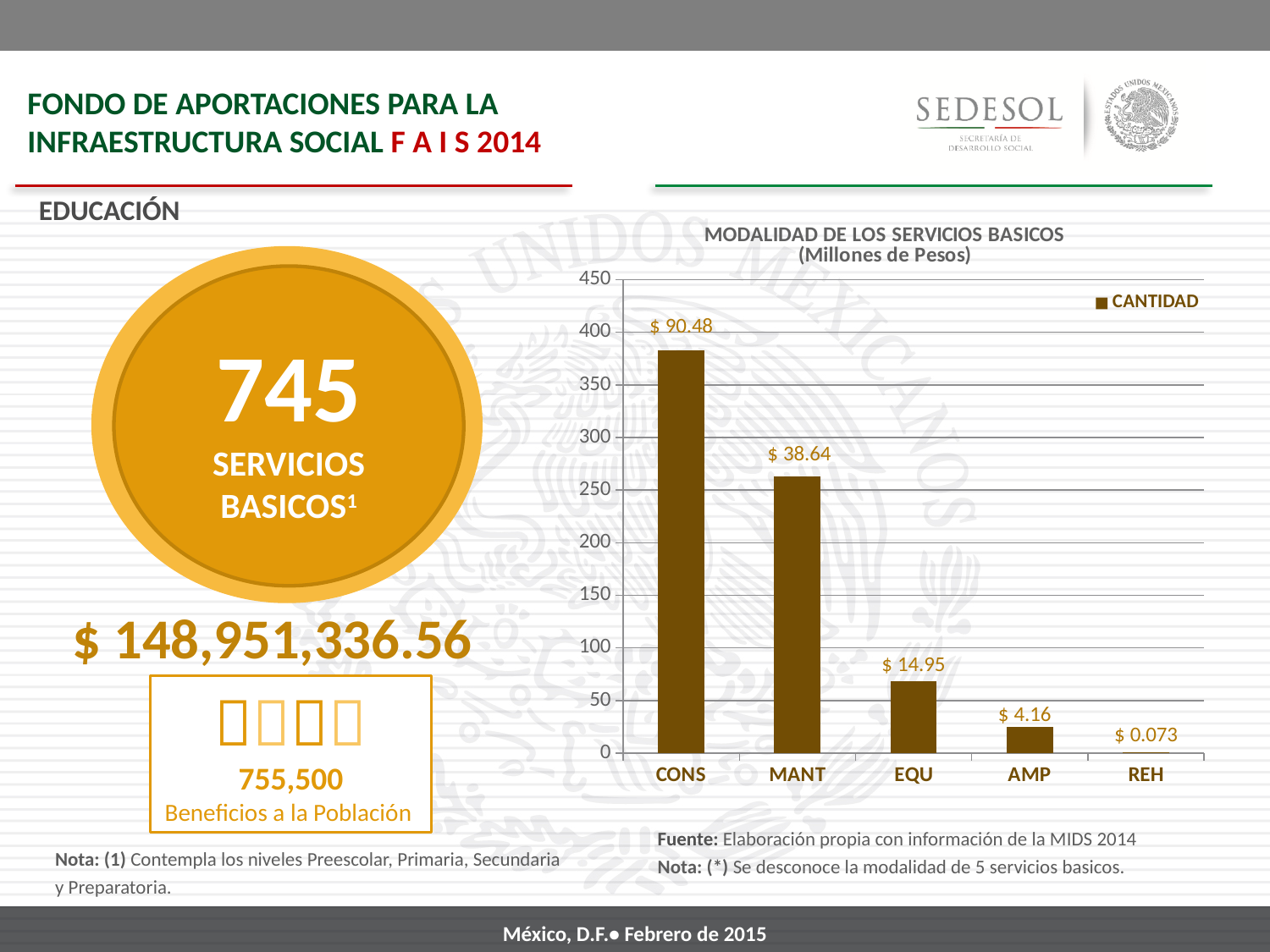
Which category has the lowest value in the chart? REH What is the value shown for CONS in the chart? $ 90.48 Which is larger, the value for EQU or the value for AMP? EQU How many series does the chart legend list? 1 What is the value shown for EQU in the chart? $ 14.95 How many categories are shown on the x axis of the chart? 5 What is the difference between the values for CONS and MANT? $ 51.84 What is the value shown for REH in the chart? $ 0.073 What kind of chart is shown on the slide? Bar chart Which category has the highest value in the chart? CONS What is the value shown for MANT in the chart? $ 38.64 What is the value shown for AMP in the chart? $ 4.16